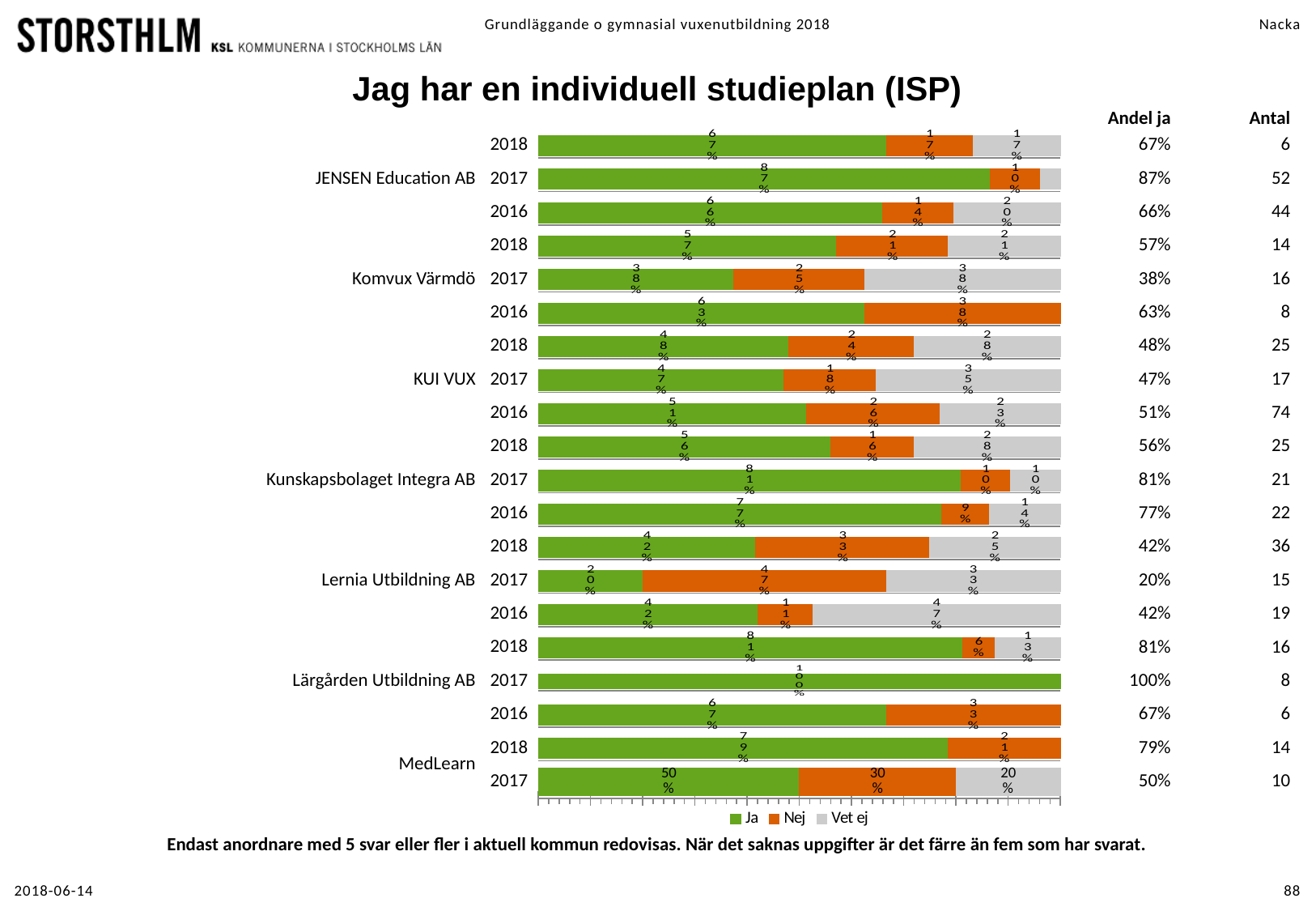
What is the Ja share for MedLearn in 2017? 50% What is the Vet ej share for Komvux Värmdö in 2017? 38% What is the Nej share for Lernia Utbildning AB in 2017? 47% How many series does the chart legend list? 3 How many providers are shown in the chart? 7 What is the Vet ej share for Lernia Utbildning AB in 2016? 47% What is the difference in Ja share for Lernia Utbildning AB between 2018 and 2017? 22 percentage points What are the legend entries of the chart? Ja, Nej, Vet ej What kind of chart is shown on the slide? Stacked bar chart For KUI VUX, which year has the larger Ja share, 2016 or 2018? 2016 Which provider and year has the lowest Ja share? Lernia Utbildning AB 2017 (20%) Which provider and year has the highest Ja share? Lärgården Utbildning AB 2017 (100%)